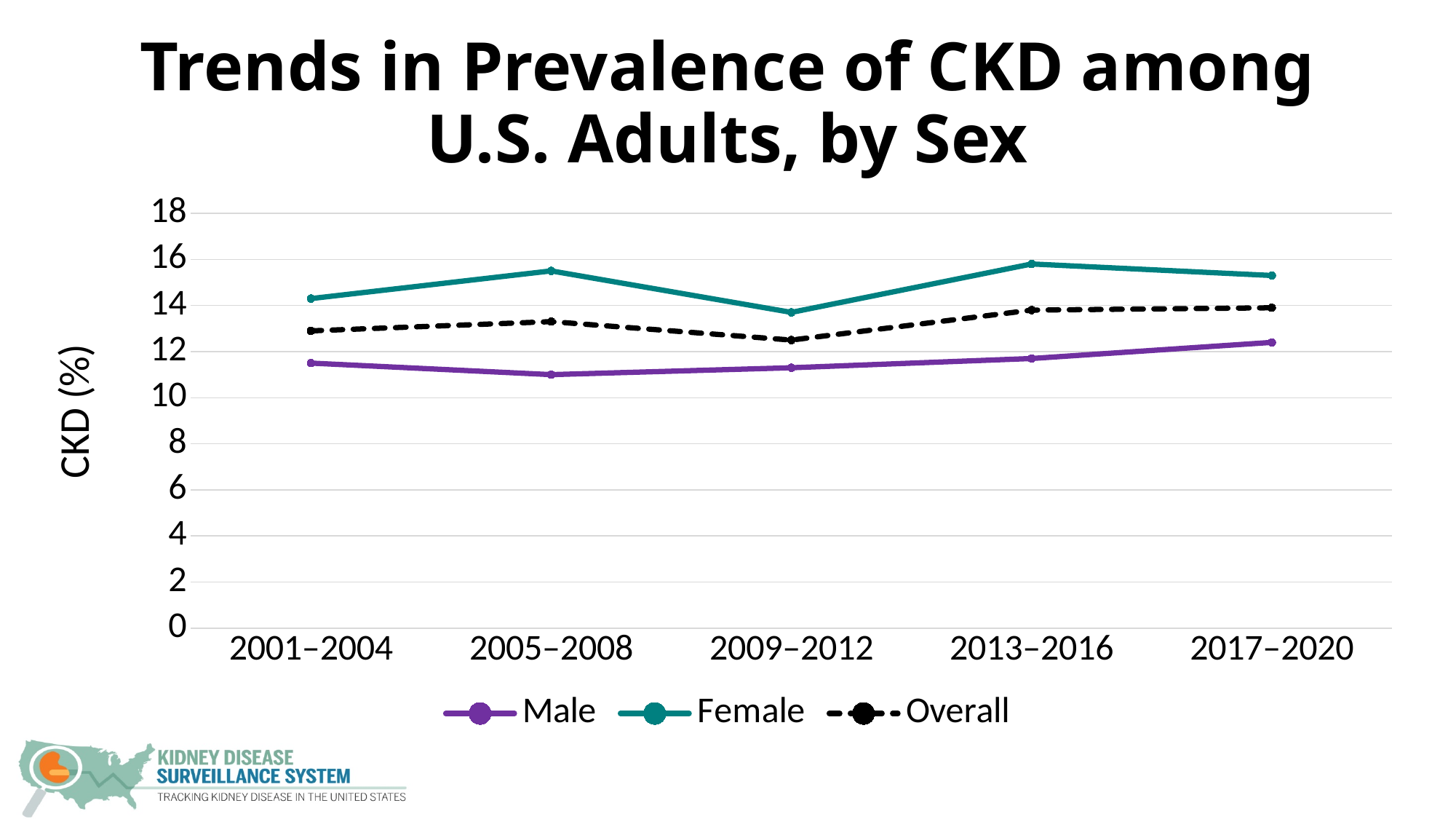
In which period is the Overall CKD prevalence lowest? 2009–2012 In which period is the Female CKD prevalence lowest? 2009–2012 In which period is the Male CKD prevalence highest? 2017–2020 How many time periods are shown on the x axis? 5 Does the Male line rise or fall from 2005–2008 to 2017–2020? rise Is the Male value for 2005–2008 greater or less than 12? less What kind of chart is shown on the slide? line chart How many series does the legend list? 3 Is the Female value for 2005–2008 greater or less than 14? greater What is the label on the y axis? CKD (%) In which period is the Male CKD prevalence lowest? 2005–2008 Which is larger in 2009–2012, the Female value or the Male value? Female